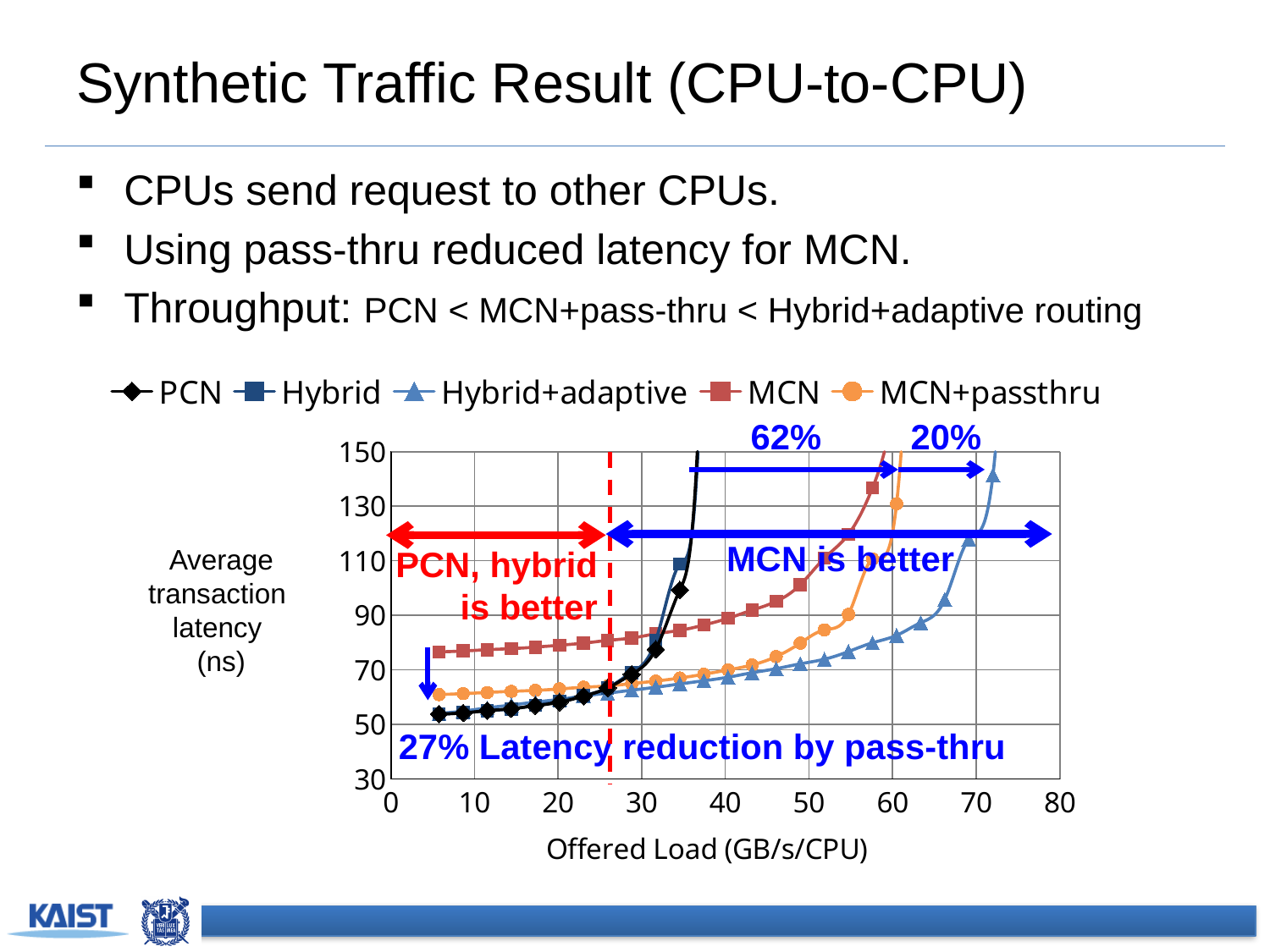
How many series does the chart legend list? 5 What kind of chart is shown on the slide? line chart At an offered load of 10 GB/s/CPU, is the latency for PCN greater or less than 70 ns? less What quantity is plotted on the y axis of the chart? Average transaction latency (ns) At an offered load of 60 GB/s/CPU, is the latency for Hybrid+adaptive greater or less than 90 ns? less Which series has the highest latency at an offered load of 10 GB/s/CPU? MCN At an offered load of 10 GB/s/CPU, is the latency for MCN+passthru greater or less than 70 ns? less At an offered load of 20 GB/s/CPU, which has the higher latency, MCN or MCN+passthru? MCN Does the average transaction latency rise or fall as offered load increases along the x axis? rise What is the title of the x axis of the chart? Offered Load (GB/s/CPU)